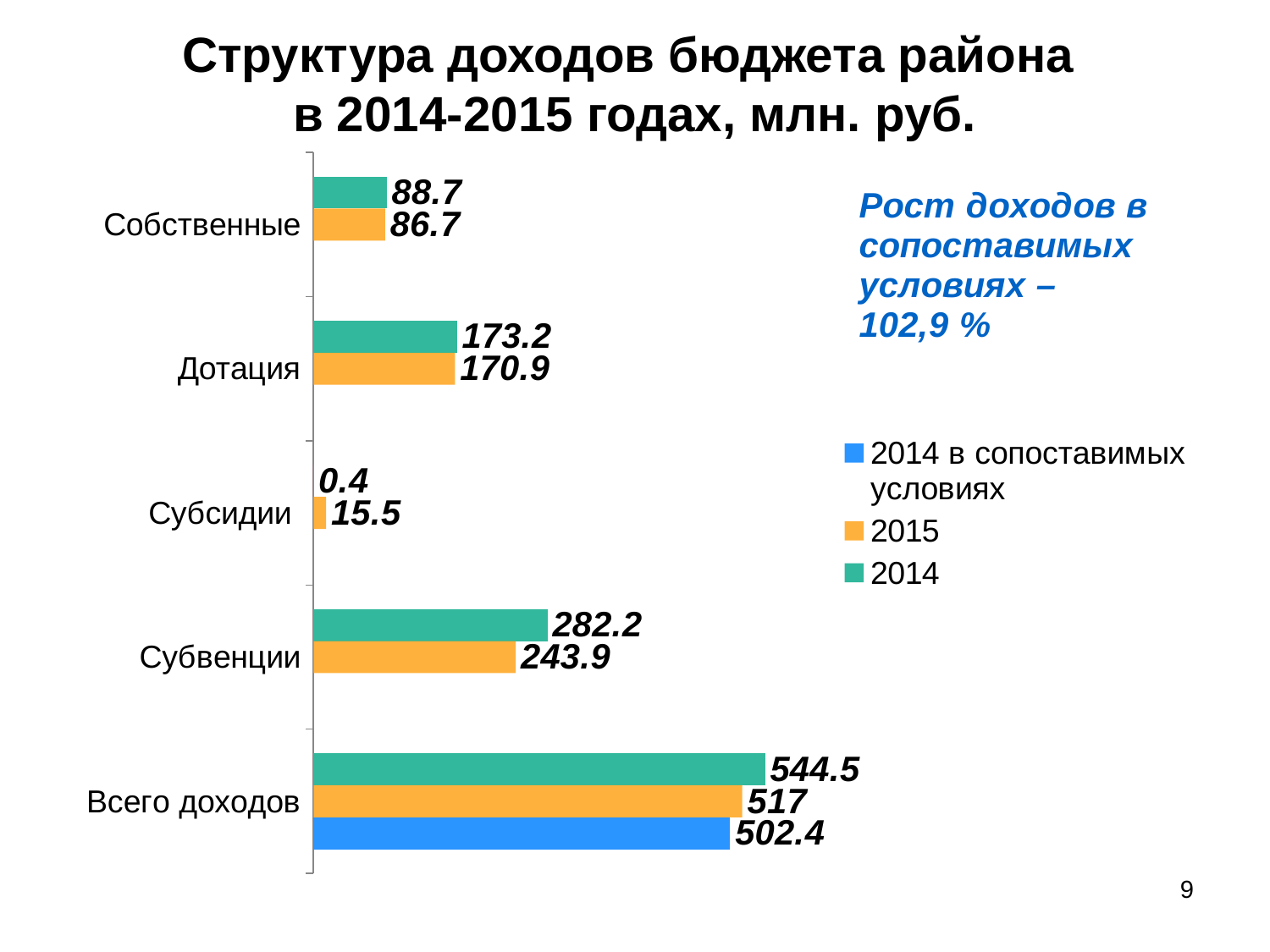
What is the 2015 value for Субсидии? 15.5 Which category has the highest 2015 value? Всего доходов How many categories are shown on the chart? 5 What is the difference between the 2014 and 2015 values for Субвенции? 38.3 What is the 2014 value for Субвенции? 282.2 What kind of chart is shown on the slide? Bar chart What is the difference between the 2014 and 2015 values for Всего доходов? 27.5 What is the 2015 value for Дотация? 170.9 How many series does the legend list? 3 Which category has the lowest 2014 value? Субсидии What is the value for Всего доходов in the series '2014 в сопоставимых условиях'? 502.4 Which is larger for Собственные: the 2014 value or the 2015 value? 2014